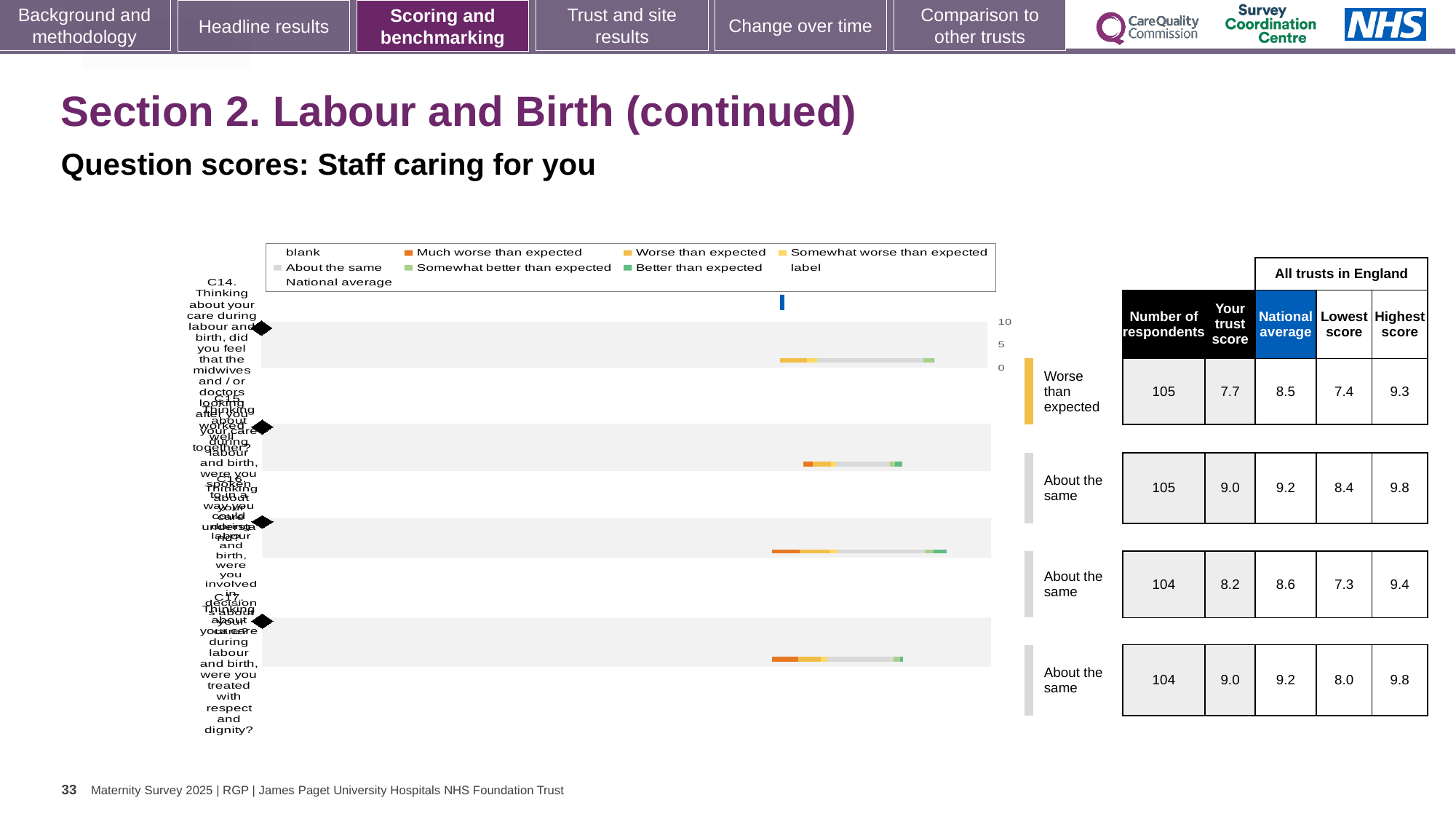
How many rows are rated 'About the same'? 3 What is the national average for the first row (C14)? 8.5 For the third row (C16), which is larger: the trust score or the national average? the national average Which row has the lowest 'Your trust score'? the first row (C14) How many respondents are listed for the fourth row (C17)? 104 What is the difference between the national average and the trust score for the first row (C14)? 0.8 What kind of chart is shown on the slide? bar chart What is the 'Your trust score' for the first row (C14)? 7.7 What is the difference between the highest score and the lowest score for the first row (C14)? 1.9 What benchmark category is shown for the first row (C14)? Worse than expected How many questions (rows) are plotted in the chart? 4 What is the highest score among all trusts in England for the second row (C15)? 9.8